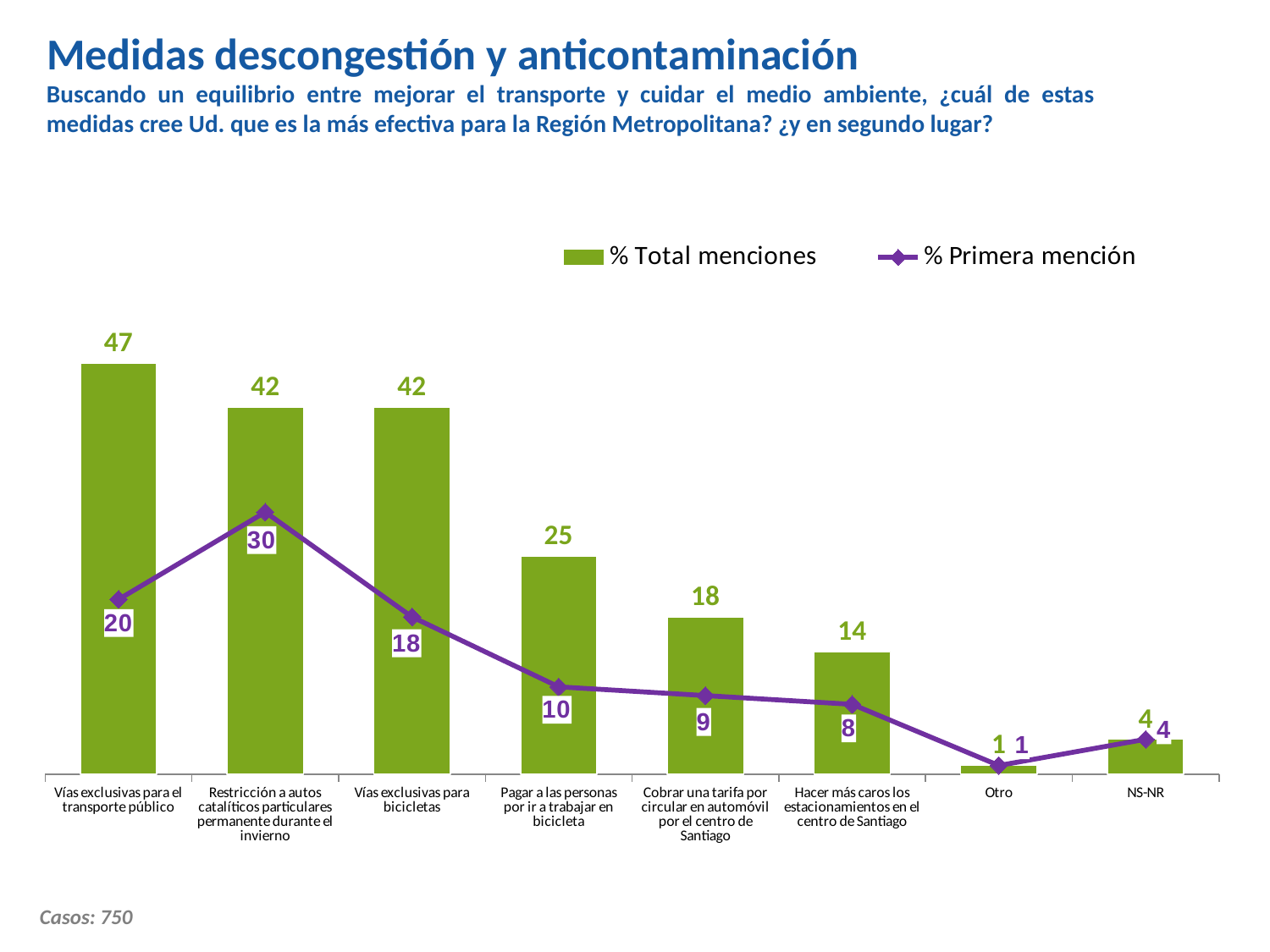
Which is larger: the % Primera mención value for 'Vías exclusivas para el transporte público' or for 'Restricción a autos catalíticos particulares permanente durante el invierno'? Restricción a autos catalíticos particulares permanente durante el invierno Which series is drawn as a line with markers in the chart? % Primera mención How many series does the chart legend list? 2 How many categories are shown on the x axis of the chart? 8 Which category has the highest % Primera mención value? Restricción a autos catalíticos particulares permanente durante el invierno What is the difference between the % Total menciones and % Primera mención values for 'Vías exclusivas para bicicletas'? 24 What is the % Primera mención value for 'Hacer más caros los estacionamientos en el centro de Santiago'? 8 What is the % Primera mención value for 'Restricción a autos catalíticos particulares permanente durante el invierno'? 30 What is the % Total menciones value for 'Pagar a las personas por ir a trabajar en bicicleta'? 25 What is the % Total menciones value for 'Vías exclusivas para el transporte público'? 47 Which category has the highest % Total menciones value? Vías exclusivas para el transporte público Which category has the lowest % Total menciones value? Otro